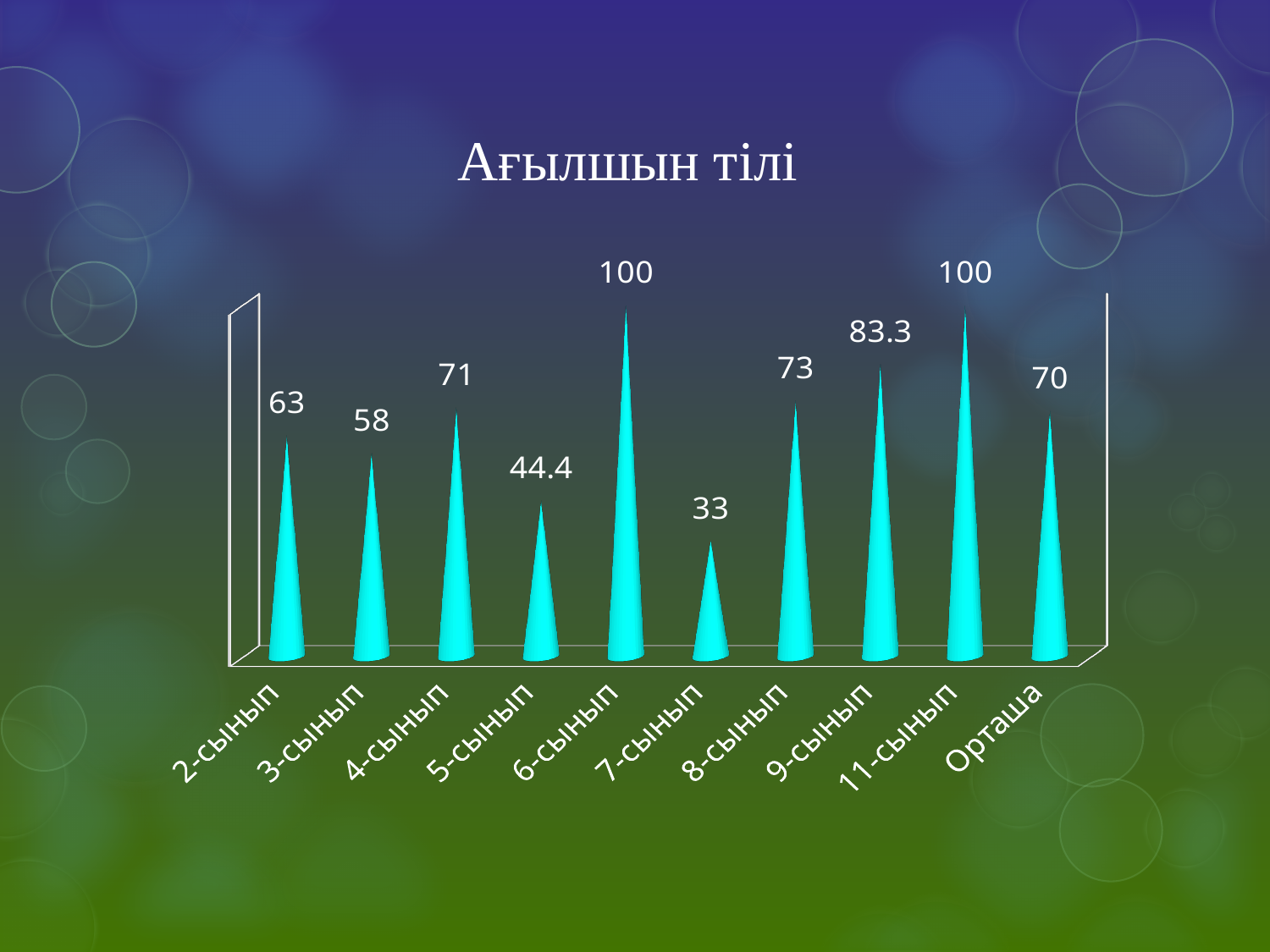
What is the value for 9-сынып? 83.3 What is the value for 5-сынып? 44.4 What is the title of the chart? Ағылшын тілі Which category has the lowest value? 7-сынып What kind of chart is shown on the slide? bar chart Which categories share the highest value of 100? 6-сынып and 11-сынып How many categories are shown on the x axis? 10 What is the value for 2-сынып? 63 What is the difference between the values for 8-сынып and 3-сынып? 15 Which is larger, the value for 4-сынып or the value for 2-сынып? 4-сынып What is the difference between the values for 6-сынып and 7-сынып? 67 What is the value for Орташа? 70